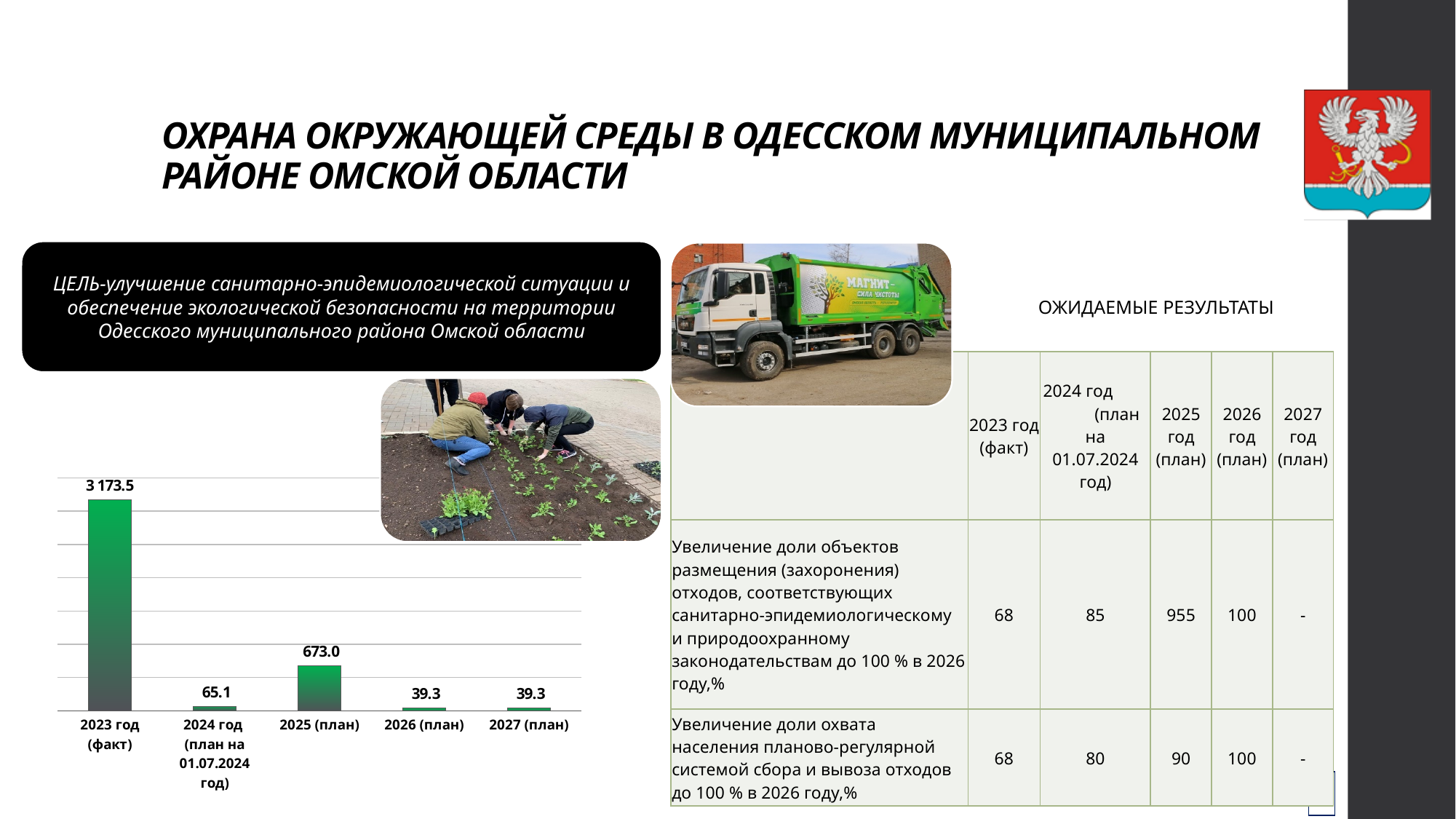
Does the value in the bar chart rise or fall from 2025 (план) to 2026 (план)? Fall What is the value shown for 2023 год (факт) in the bar chart? 3 173.5 What is the difference between the values for 2025 (план) and 2024 год (план на 01.07.2024 год) in the bar chart? 607.9 Which is larger in the bar chart: the value for 2025 (план) or the value for 2024 год (план на 01.07.2024 год)? 2025 (план) How many categories are shown in the bar chart? 5 What is the value shown for 2024 год (план на 01.07.2024 год) in the bar chart? 65.1 What kind of chart is shown on the left of the slide? Bar chart What is the value shown for 2025 (план) in the bar chart? 673.0 What is the difference between the values for 2023 год (факт) and 2025 (план) in the bar chart? 2 500.5 What is the value shown for 2027 (план) in the bar chart? 39.3 Do the values for 2026 (план) and 2027 (план) in the bar chart differ? No, both are 39.3 Which category has the highest value in the bar chart? 2023 год (факт)